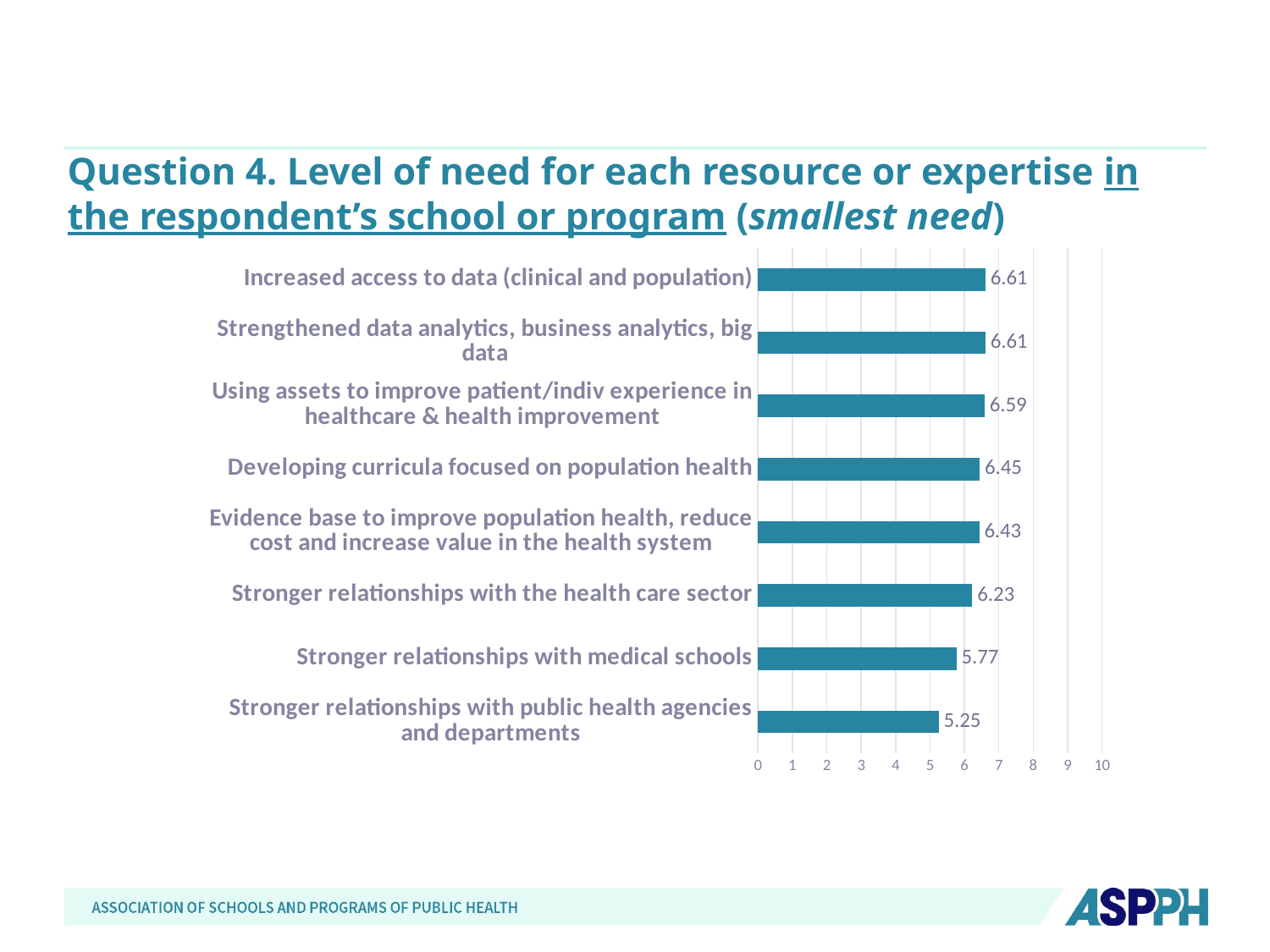
Which is larger: the value for 'Developing curricula focused on population health' or the value for 'Stronger relationships with medical schools'? Developing curricula focused on population health What is the difference between the values for 'Stronger relationships with the health care sector' and 'Stronger relationships with medical schools'? 0.46 What is the maximum value shown on the horizontal axis? 10 What value is shown for 'Evidence base to improve population health, reduce cost and increase value in the health system'? 6.43 What is the value for 'Stronger relationships with the health care sector'? 6.23 What kind of chart is shown on the slide? Bar chart What is the difference between the values for 'Increased access to data (clinical and population)' and 'Stronger relationships with public health agencies and departments'? 1.36 How many categories are shown in the chart? 8 What is the value for 'Developing curricula focused on population health'? 6.45 Is the value for 'Stronger relationships with public health agencies and departments' greater or less than 6? less Which category has the lowest value? Stronger relationships with public health agencies and departments What is the value for 'Stronger relationships with medical schools'? 5.77